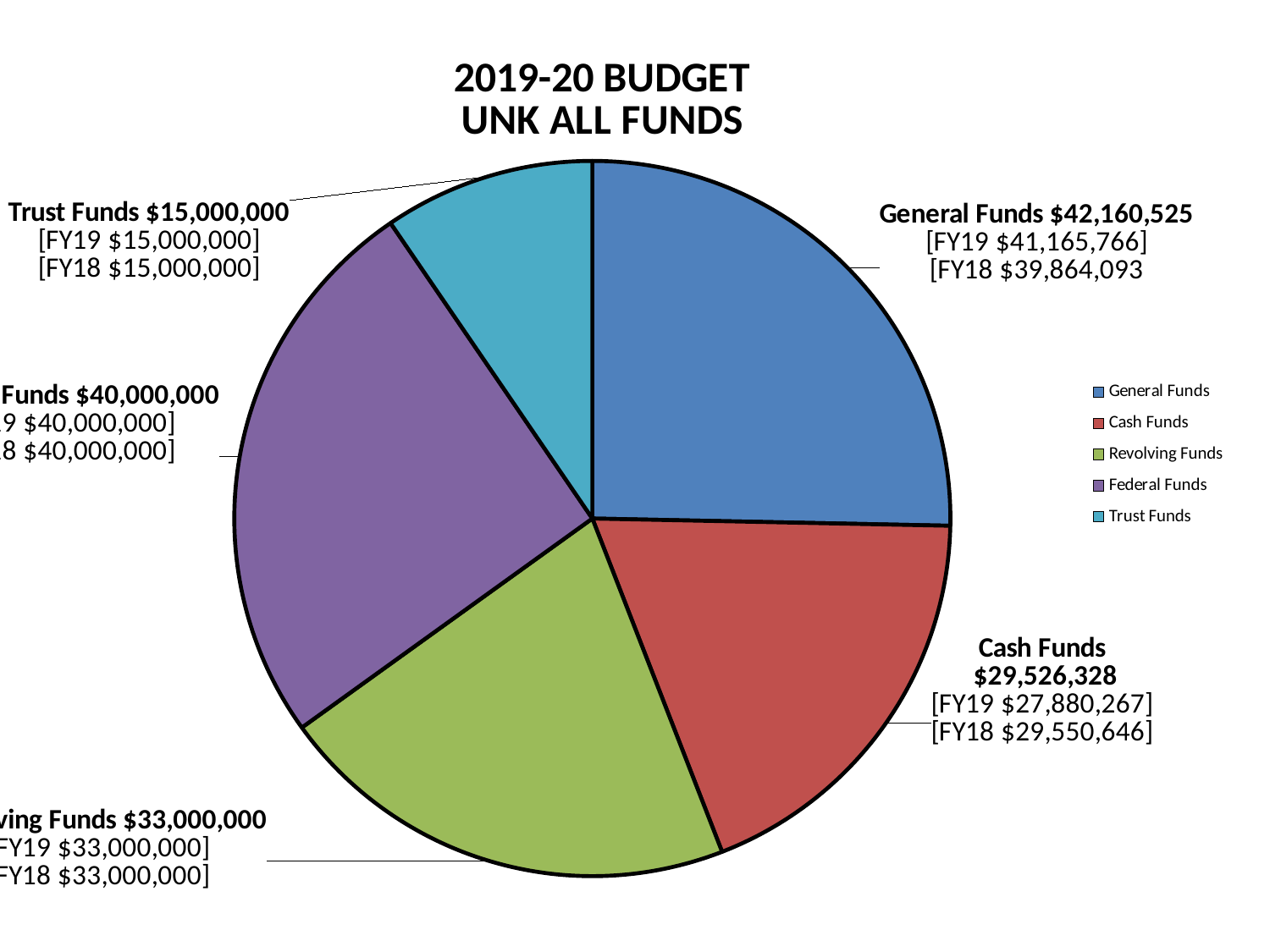
What was the FY19 value for Cash Funds? $27,880,267 Which fund category has the smallest slice of the pie? Trust Funds What is the 2019-20 budget value for Cash Funds? $29,526,328 What type of chart is shown on the slide? Pie chart What is the 2019-20 budget value for General Funds? $42,160,525 What is the difference between the General Funds and Cash Funds values? $12,634,197 How many slices does the pie chart have? 5 What colour is the Trust Funds slice? Teal (light blue) What is the title of the chart? 2019-20 BUDGET UNK ALL FUNDS Which is larger, Federal Funds or Revolving Funds? Federal Funds How many entries does the legend list? 5